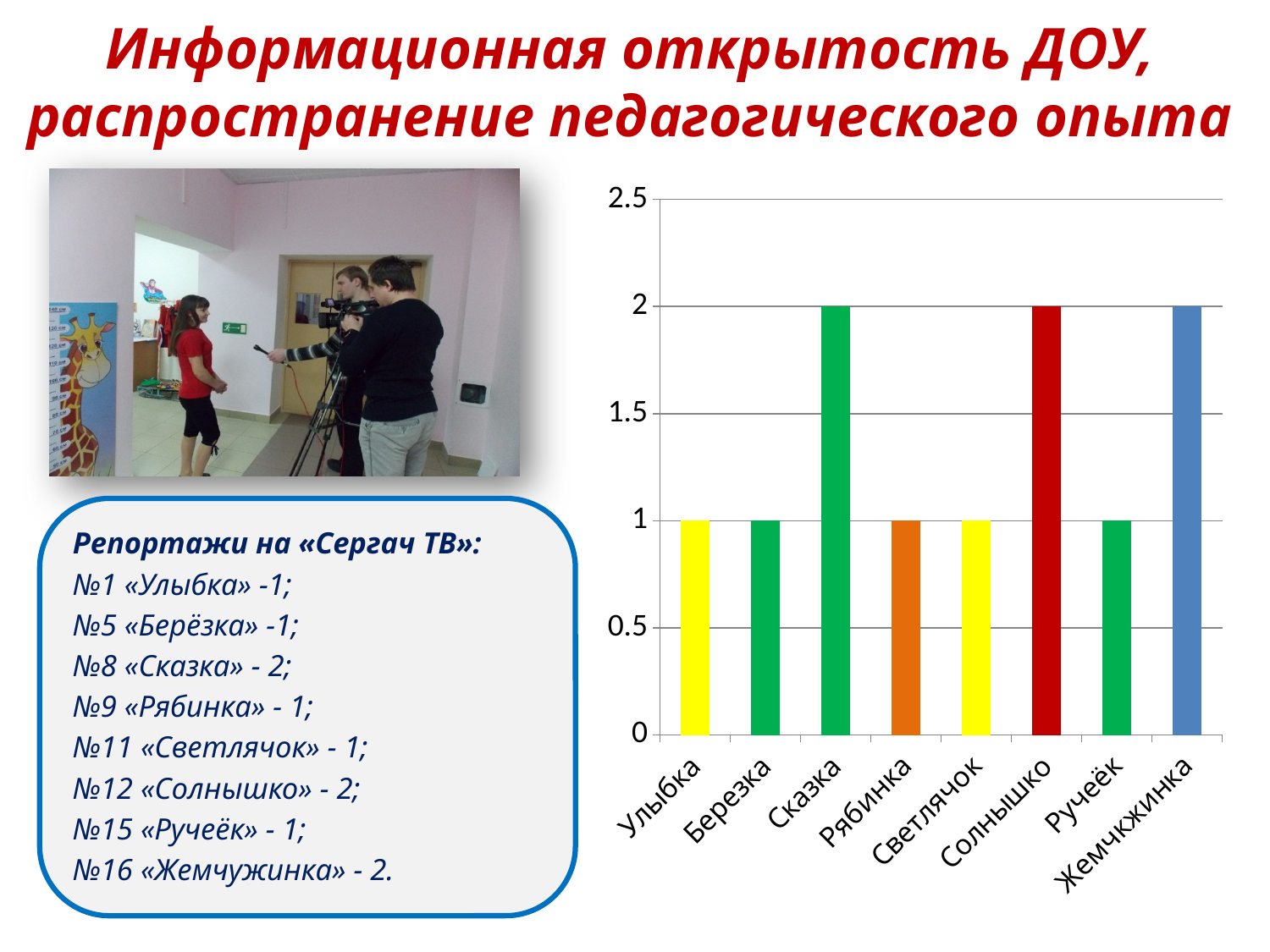
How many categories in the chart have a value of 2? 3 Is the value for Ручеёк greater or less than 1.5? less Which is larger in the chart, the value for Ручеёк or the value for Жемчкжинка? Жемчкжинка Which is larger in the chart, the value for Сказка or the value for Березка? Сказка What is the value for Сказка in the chart? 2 What is the value for Рябинка in the chart? 1 What kind of chart is shown on the slide? bar chart What is the difference between the values for Солнышко and Светлячок in the chart? 1 Is the value for Сказка greater or less than 1.5? greater What is the value for Солнышко in the chart? 2 How many categories are shown on the x axis of the chart? 8 What is the value for Улыбка in the chart? 1